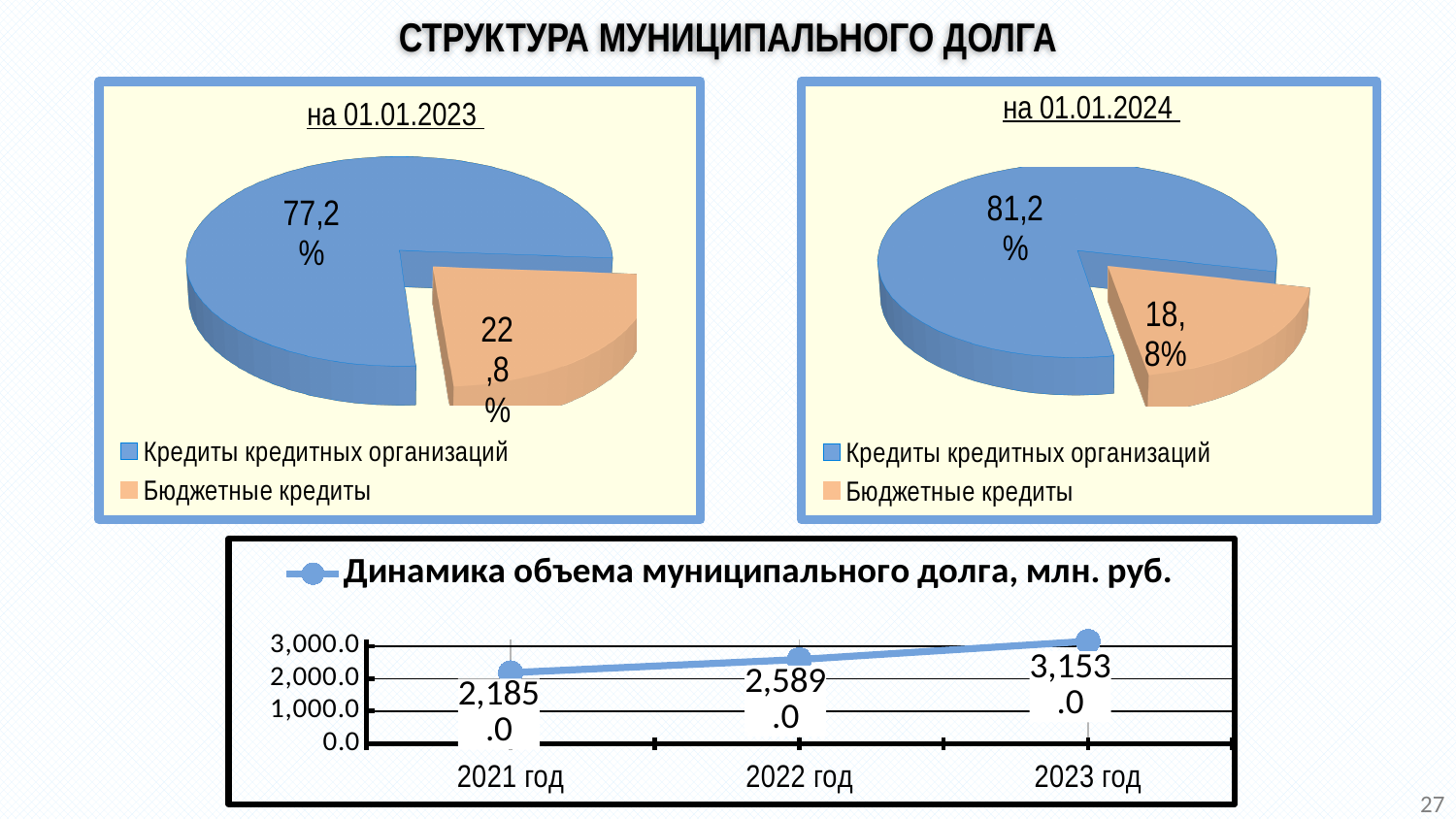
In the pie chart 'на 01.01.2023', what share is labelled for Кредиты кредитных организаций? 77,2% In the chart 'Динамика объема муниципального долга, млн. руб.', do the values rise or fall from 2021 год to 2023 год? Rise In the pie chart 'на 01.01.2024', which category has the largest slice? Кредиты кредитных организаций In the pie chart 'на 01.01.2024', what share is labelled for Кредиты кредитных организаций? 81,2% What kind of chart is the chart titled 'на 01.01.2023'? Pie chart In the pie chart 'на 01.01.2023', how many categories does the legend list? 2 In the pie chart 'на 01.01.2024', what share is labelled for Бюджетные кредиты? 18,8% In the pie chart 'на 01.01.2023', what share is labelled for Бюджетные кредиты? 22,8% In the chart 'Динамика объема муниципального долга, млн. руб.', what is the value for 2021 год? 2,185.0 In the chart 'Динамика объема муниципального долга, млн. руб.', what is the difference between the values for 2023 год and 2022 год? 564.0 In the chart 'Динамика объема муниципального долга, млн. руб.', what is the value for 2023 год? 3,153.0 What kind of chart is 'Динамика объема муниципального долга, млн. руб.'? Line chart